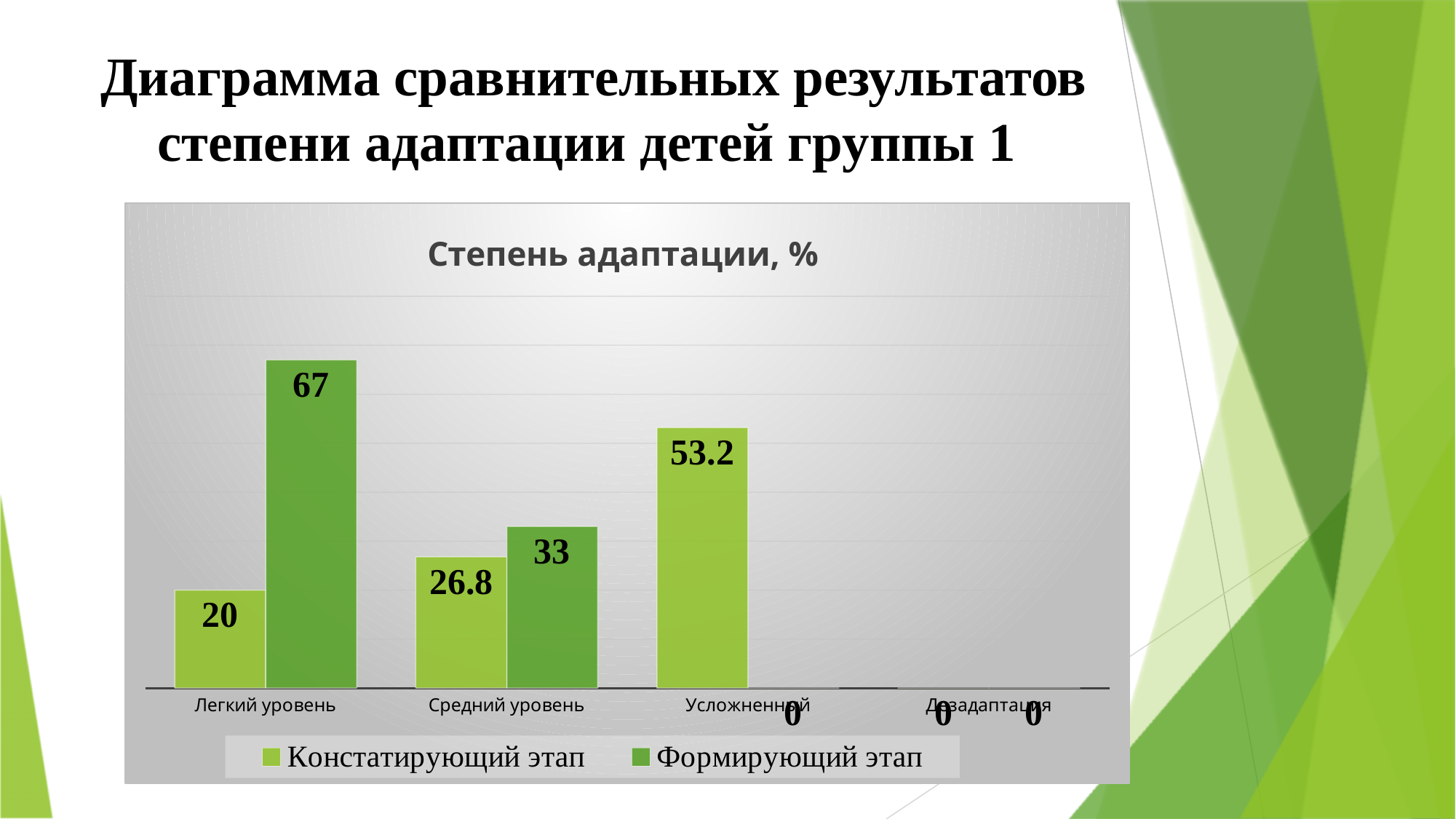
What type of chart is shown on the slide? bar chart How many categories are shown on the x axis? 4 Which category has the highest value in the Формирующий этап series? Легкий уровень Which is larger for Средний уровень: the Констатирующий этап value or the Формирующий этап value? Формирующий этап How many series does the legend list? 2 What is the difference between the Формирующий этап and Констатирующий этап values for Средний уровень? 6.2 What is the value for Легкий уровень in the Констатирующий этап series? 20 What is the difference between the Формирующий этап and Констатирующий этап values for Легкий уровень? 47 What is the value for Средний уровень in the Констатирующий этап series? 26.8 Which category has the highest value in the Констатирующий этап series? Усложненный What is the value for Легкий уровень in the Формирующий этап series? 67 What is the value for Усложненный in the Констатирующий этап series? 53.2